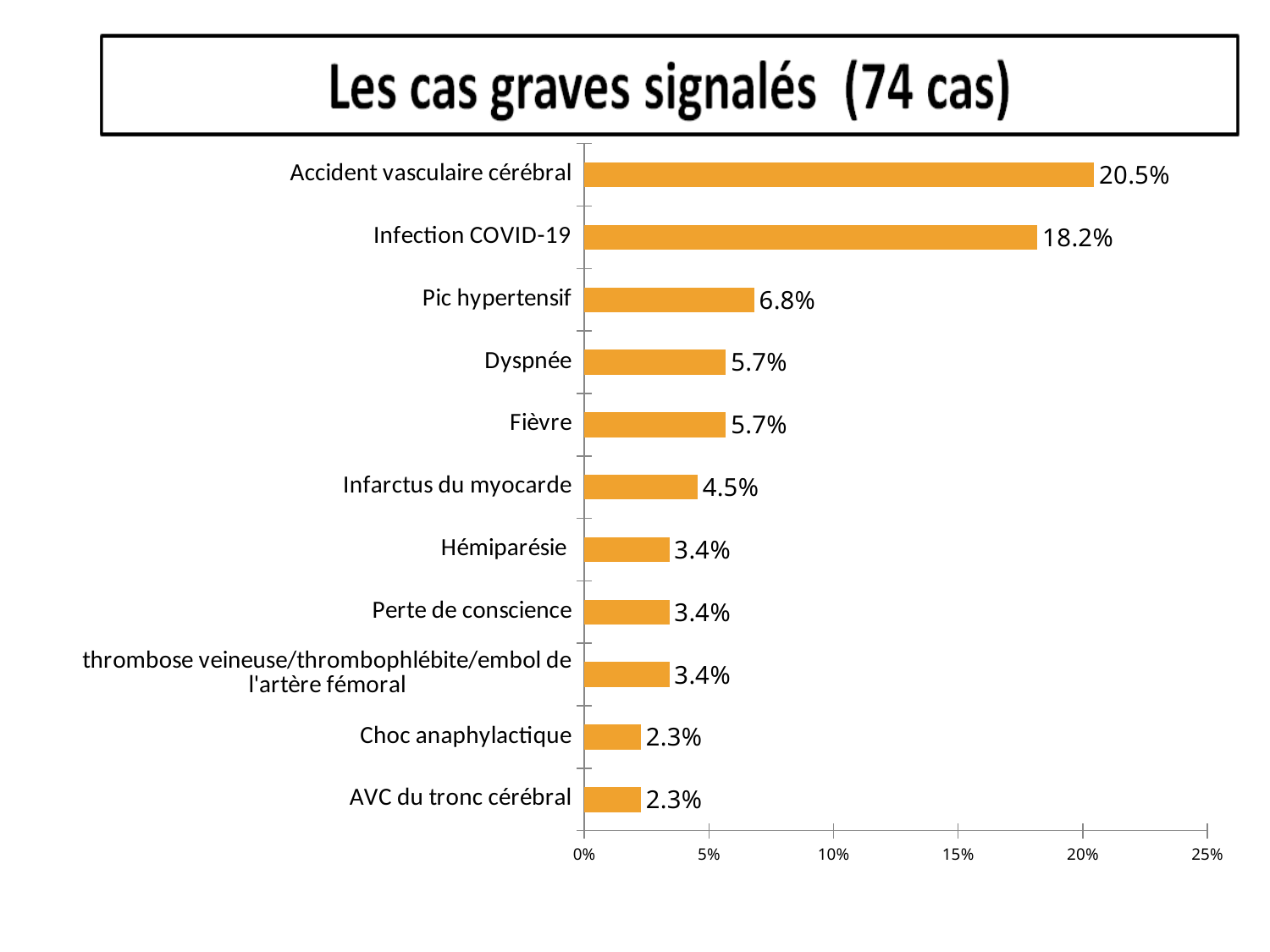
Which category has the highest value? Accident vasculaire cérébral What is the title of the chart? Les cas graves signalés (74 cas) Which is larger, the value for Pic hypertensif or the value for Dyspnée? Pic hypertensif What is the value for Choc anaphylactique? 2.3% What is the value for Infection COVID-19? 18.2% How many categories are shown in the chart? 11 What is the value for Infarctus du myocarde? 4.5% What is the value for Accident vasculaire cérébral? 20.5% Is the value for Infection COVID-19 greater or less than 15%? greater What is the value for Pic hypertensif? 6.8% What is the difference between the values for Accident vasculaire cérébral and Infection COVID-19? 2.3% What kind of chart is shown on the slide? bar chart